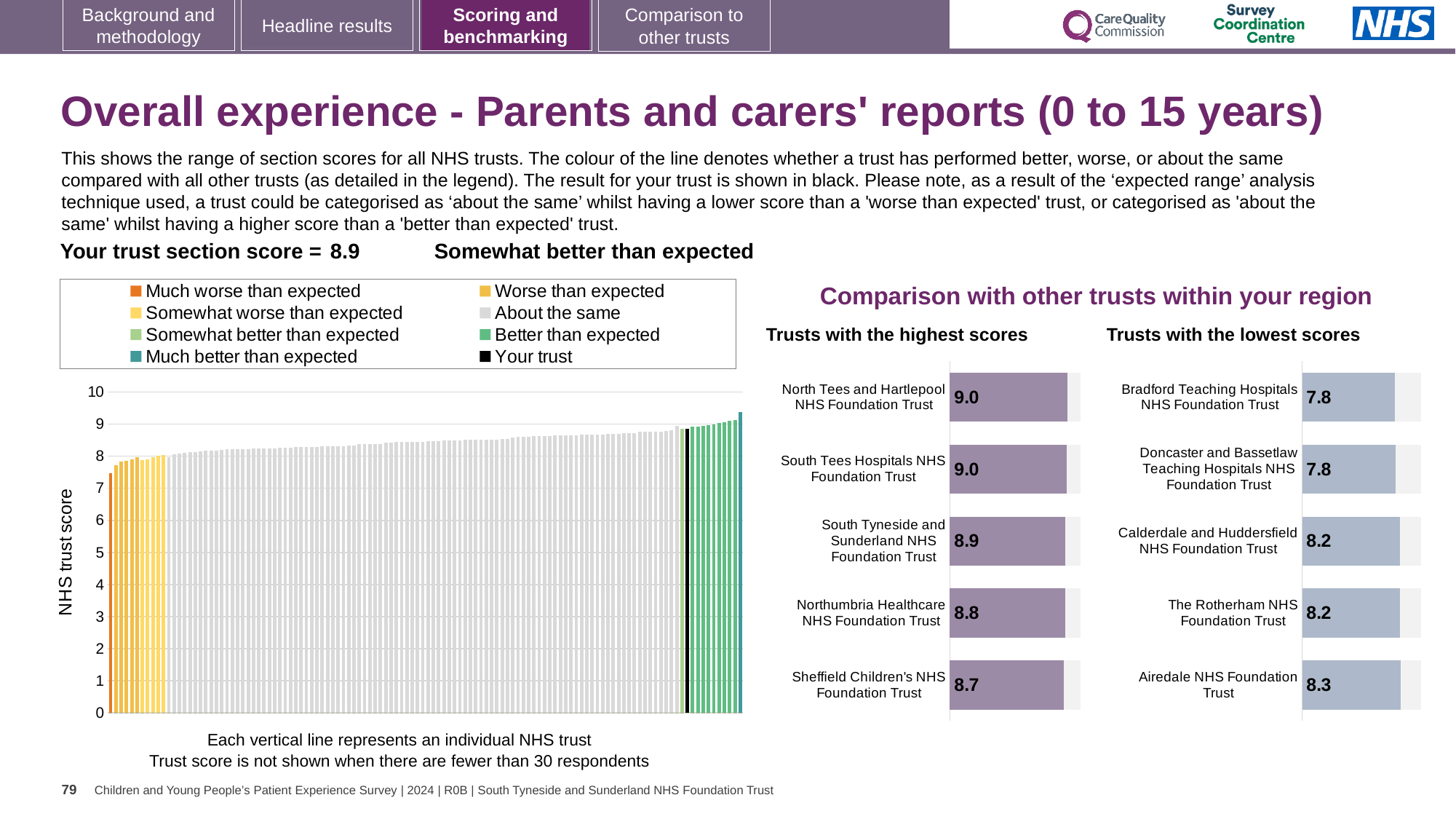
How many trusts are listed in the 'Trusts with the highest scores' chart? 5 In the 'Trusts with the lowest scores' chart, which trust has the highest score? Airedale NHS Foundation Trust In the 'Trusts with the lowest scores' chart, which has the larger score: The Rotherham NHS Foundation Trust or Airedale NHS Foundation Trust? Airedale NHS Foundation Trust In the 'Trusts with the highest scores' chart, what is the difference between the scores of North Tees and Hartlepool NHS Foundation Trust and Sheffield Children's NHS Foundation Trust? 0.3 In the 'Trusts with the lowest scores' chart, what is the score for Calderdale and Huddersfield NHS Foundation Trust? 8.2 In the large 'NHS trust score' chart on the left, is the value of the lowest (leftmost) bar greater or less than 8? less How many entries does the legend of the large 'NHS trust score' chart list? 8 In the 'Trusts with the lowest scores' chart, what is the difference between the scores of Airedale NHS Foundation Trust and Bradford Teaching Hospitals NHS Foundation Trust? 0.5 In the 'Trusts with the highest scores' chart, what is the score for Northumbria Healthcare NHS Foundation Trust? 8.8 In the 'Trusts with the highest scores' chart, what is the score for Sheffield Children's NHS Foundation Trust? 8.7 In the 'Trusts with the highest scores' chart, which trust has the lowest score? Sheffield Children's NHS Foundation Trust In the large 'NHS trust score' chart on the left, do the bar values rise or fall from left to right along the x axis? rise